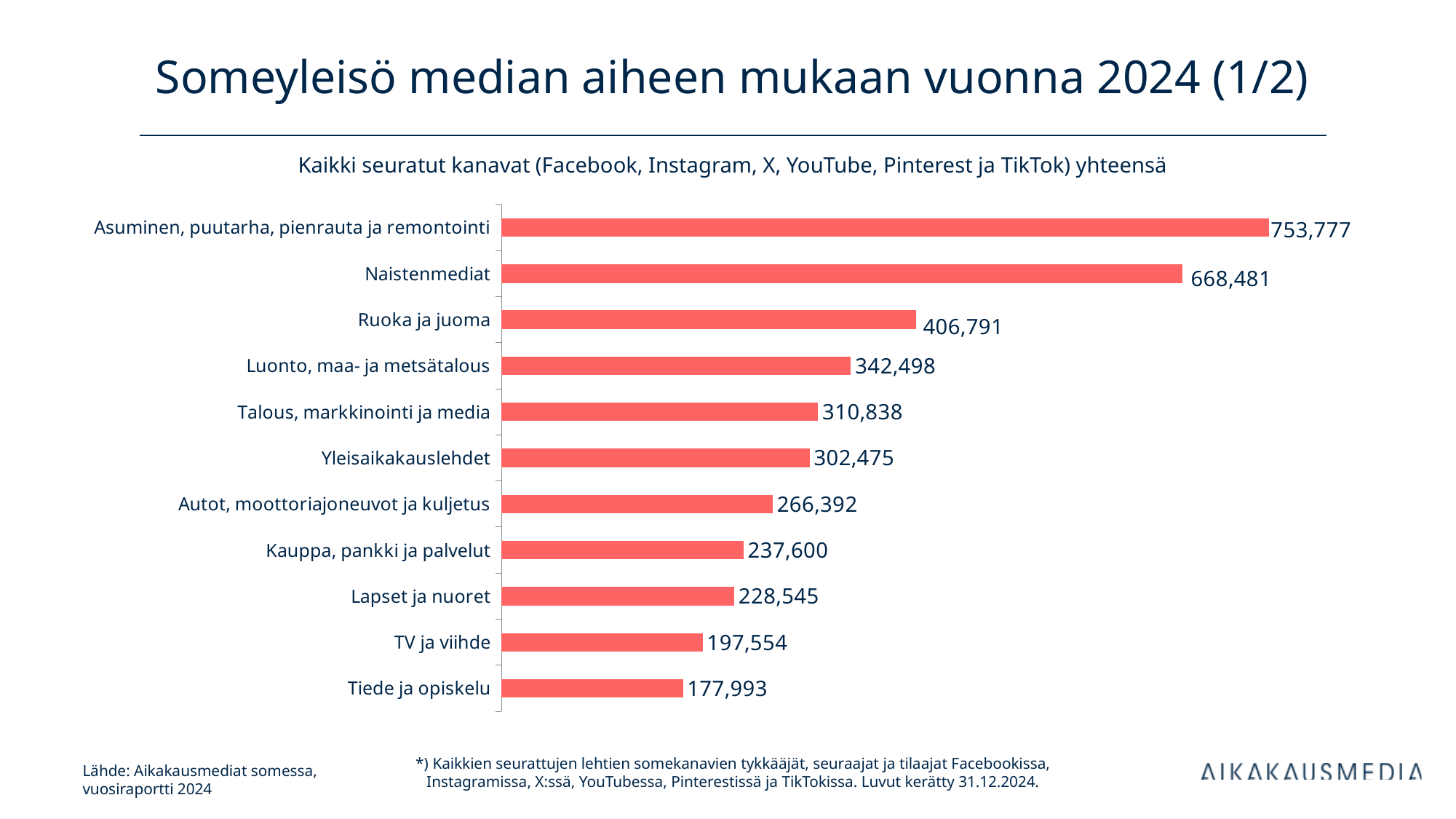
What is the value for Ruoka ja juoma? 406,791 How many categories are shown in the chart? 11 What is the value for Tiede ja opiskelu? 177,993 What is the value for Naistenmediat? 668,481 What kind of chart is shown on the slide? Bar chart What is the difference between the values for Asuminen, puutarha, pienrauta ja remontointi and Naistenmediat? 85,296 Which is larger, the value for Luonto, maa- ja metsätalous or the value for Talous, markkinointi ja media? Luonto, maa- ja metsätalous What is the value for Lapset ja nuoret? 228,545 What is the subtitle shown above the chart? Kaikki seuratut kanavat (Facebook, Instagram, X, YouTube, Pinterest ja TikTok) yhteensä Which category has the highest value? Asuminen, puutarha, pienrauta ja remontointi What is the difference between the values for TV ja viihde and Tiede ja opiskelu? 19,561 Which category has the lowest value? Tiede ja opiskelu